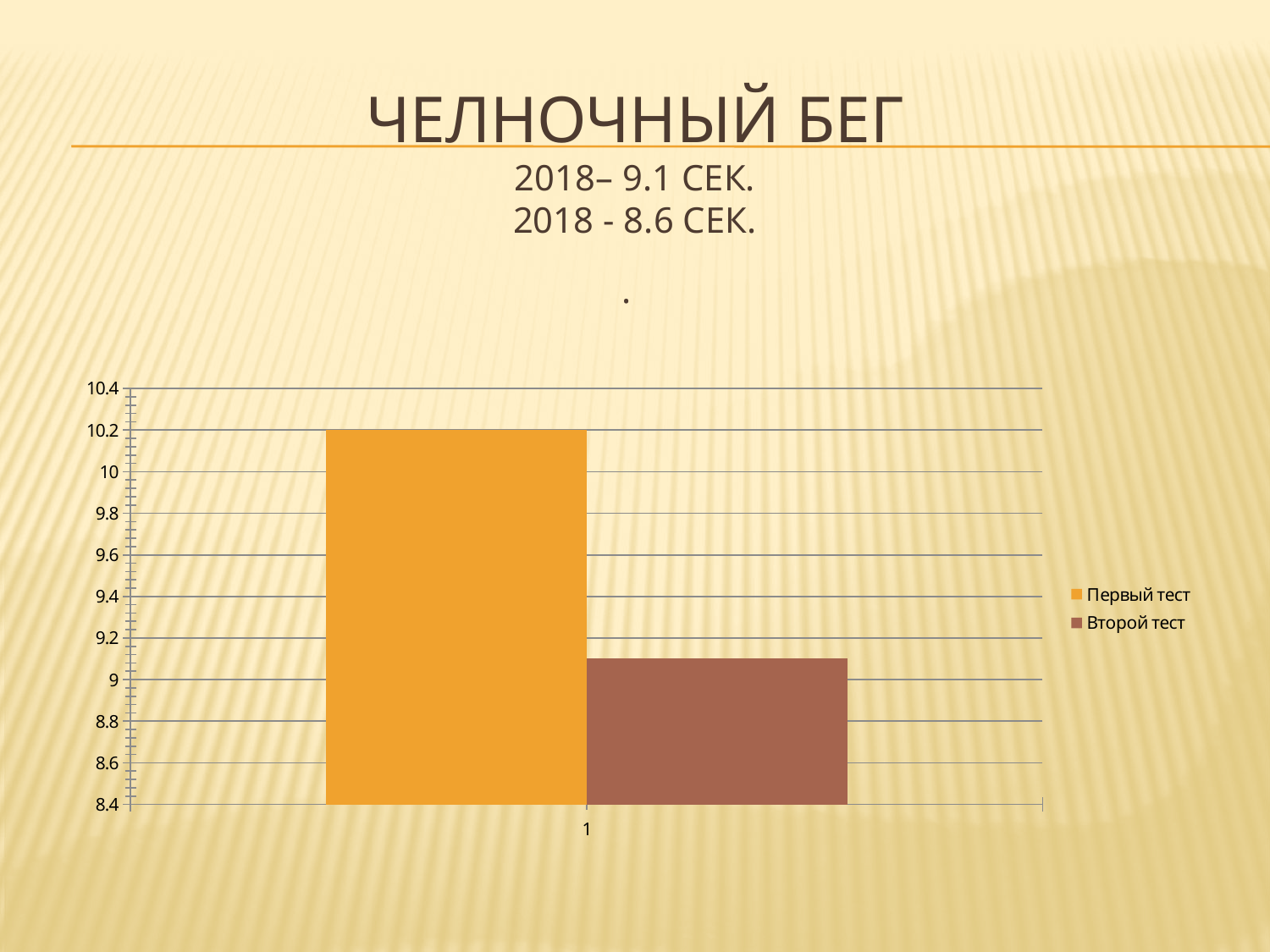
Which series has the tallest bar in the chart? Первый тест How many series does the chart legend list? 2 Is the value for Второй тест greater or less than 9.2? less What kind of chart is shown on the slide? bar chart Is the value for Второй тест greater or less than 9? greater Which series has the shortest bar in the chart? Второй тест What colour is the bar for Первый тест? orange What is the value of the bar for Первый тест? 10.2 Is the value for Первый тест greater or less than 10? greater What are the two entries listed in the chart legend? Первый тест, Второй тест How many categories are shown on the x axis of the chart? 1 Which series has the higher bar, Первый тест or Второй тест? Первый тест